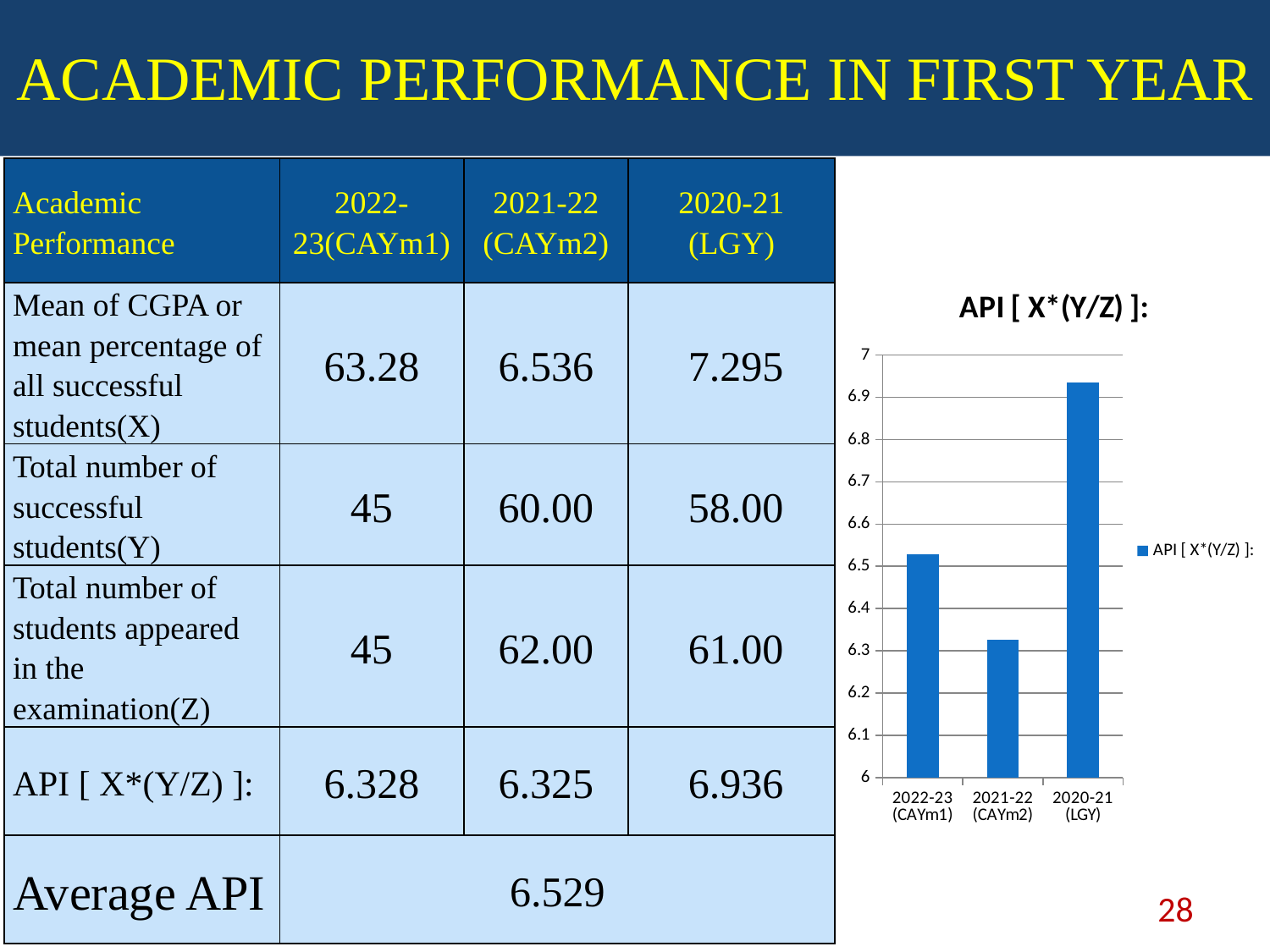
What colour are the bars in the chart? blue What kind of chart is shown on the slide? bar chart Do the bars rise or fall from 2021-22 (CAYm2) to 2020-21 (LGY)? rise Which category has the lowest bar in the chart? 2021-22 (CAYm2) Is the bar for 2022-23 (CAYm1) greater or less than 6.4? greater Is the bar for 2021-22 (CAYm2) greater or less than 6.4? less Which category has the highest bar in the chart? 2020-21 (LGY) Is the bar for 2020-21 (LGY) greater or less than 6.8? greater How many series does the chart legend list? 1 How many categories are shown on the x axis of the chart? 3 What is the title of the chart? API [ X*(Y/Z) ]: Which is larger in the chart, the bar for 2020-21 (LGY) or the bar for 2021-22 (CAYm2)? 2020-21 (LGY)